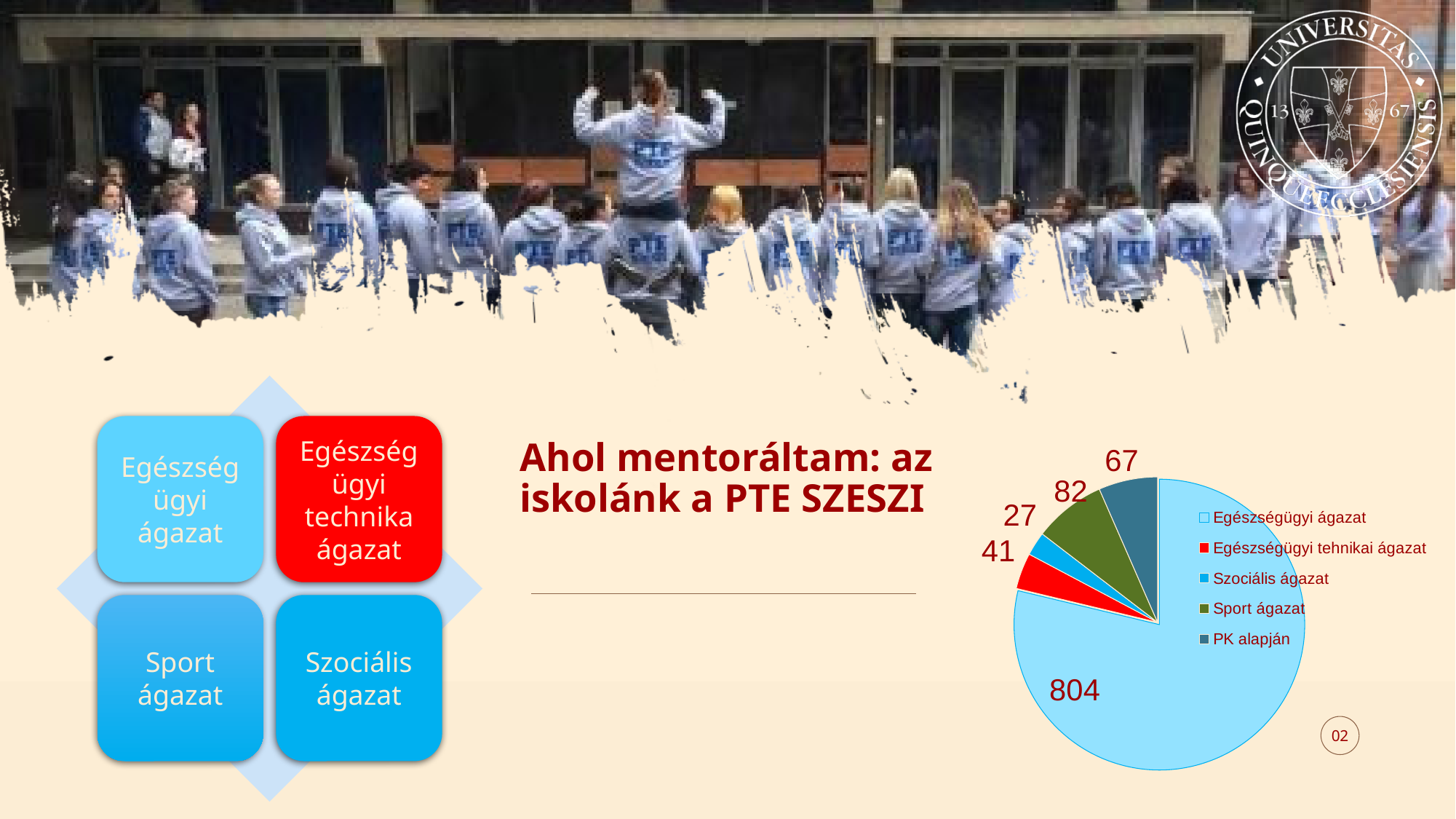
What is the total of all the values shown in the pie chart? 1021 What is the difference between the values for Sport ágazat and PK alapján? 15 Which category has the smallest slice in the pie chart? Szociális ágazat What type of chart is shown on the slide? Pie chart What colour is the Sport ágazat slice in the pie chart? Green What value is shown for PK alapján in the pie chart? 67 What value is shown for Sport ágazat in the pie chart? 82 Which is larger, the value for Egészségügyi tehnikai ágazat or the value for Szociális ágazat? Egészségügyi tehnikai ágazat Which category has the largest slice in the pie chart? Egészségügyi ágazat What value is shown for Szociális ágazat in the pie chart? 27 What value is shown for Egészségügyi ágazat in the pie chart? 804 How many slices does the pie chart have? 5